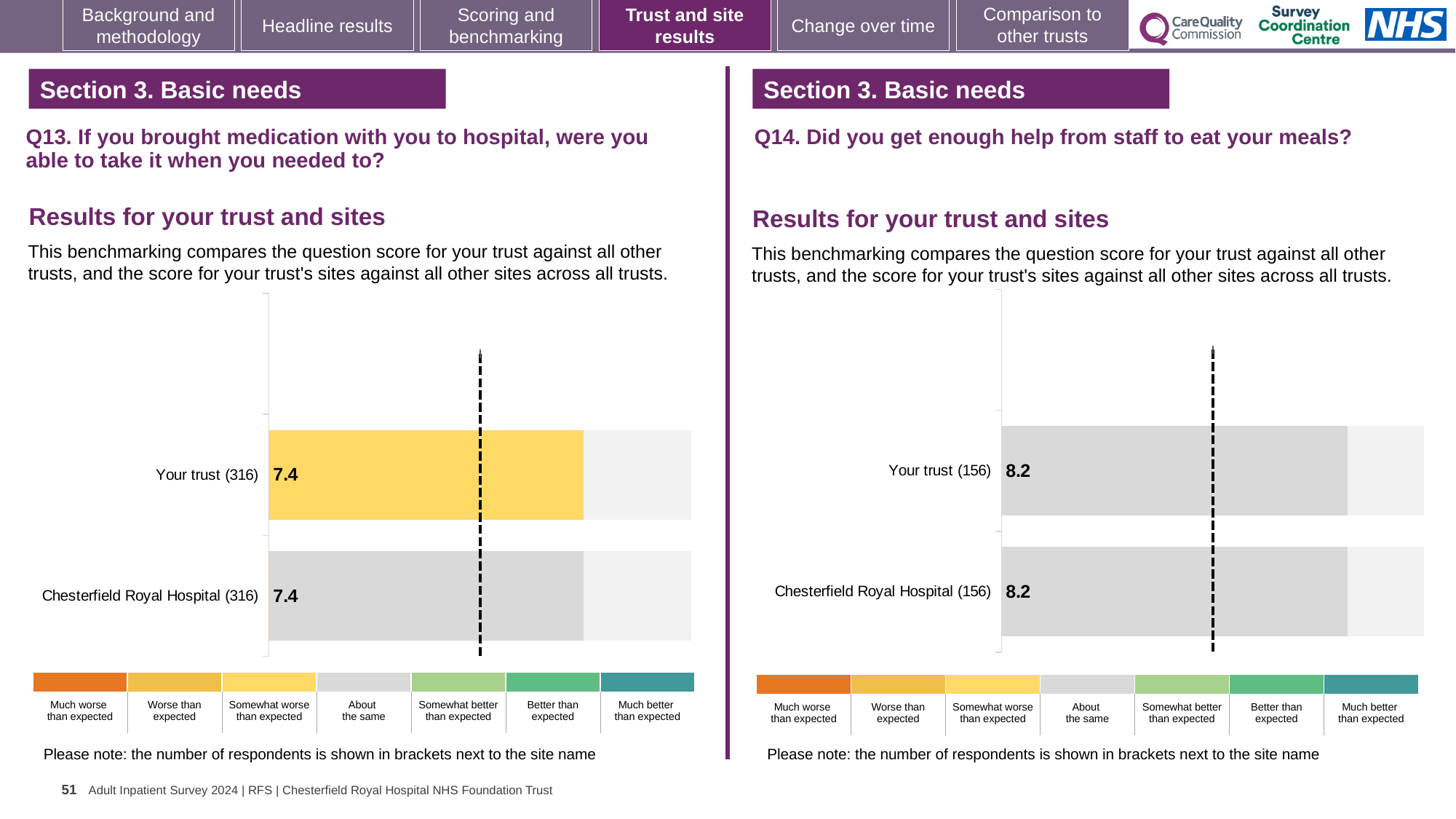
On the Q14 chart (right), what is the score for Your trust? 8.2 On the Q13 chart (left), what is the score for Your trust? 7.4 On the Q14 chart (right), how many respondents are shown in brackets for Chesterfield Royal Hospital? 156 On the Q14 chart (right), what is the score for Chesterfield Royal Hospital? 8.2 How many bars are plotted on the Q13 chart (left)? 2 On the Q13 chart (left), what is the difference between the Your trust score and the Chesterfield Royal Hospital score? 0.0 On the Q13 chart (left), how many respondents are shown in brackets for Your trust? 316 What type of chart is used on the Q13 chart (left)? Bar chart On the Q13 chart (left), what is the score for Chesterfield Royal Hospital? 7.4 On the Q13 chart (left), which benchmark category does the colour of the Your trust bar correspond to in the key? Somewhat worse than expected How many bars are plotted on the Q14 chart (right)? 2 On the Q14 chart (right), what is the difference between the Your trust score and the Chesterfield Royal Hospital score? 0.0